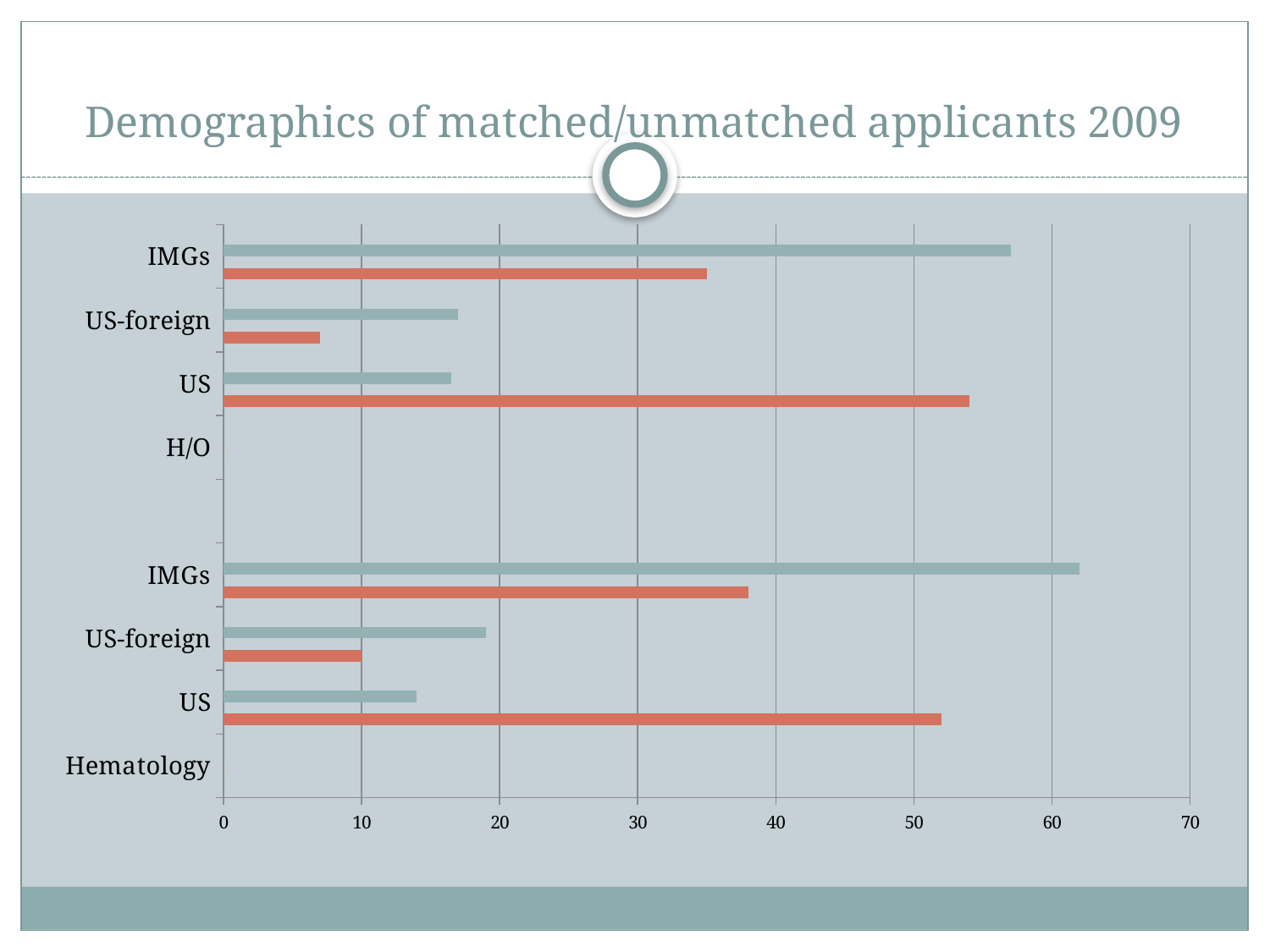
What kind of chart is shown on the slide? bar chart In the upper (H/O) group, which bar is longer for US, the teal bar or the orange bar? the orange bar In the lower (Hematology) group, is the teal bar for US greater or less than 20? less In the upper (H/O) group, is the orange bar for US greater or less than 50? greater In the lower (Hematology) group, is the teal bar for IMGs greater or less than 60? greater Which bar is the longest on the whole chart? the teal bar for IMGs in the lower (Hematology) group What is the title of the chart slide? Demographics of matched/unmatched applicants 2009 What is the highest value shown on the horizontal axis? 70 In the upper (H/O) group, which bar is longer for IMGs, the teal bar or the orange bar? the teal bar